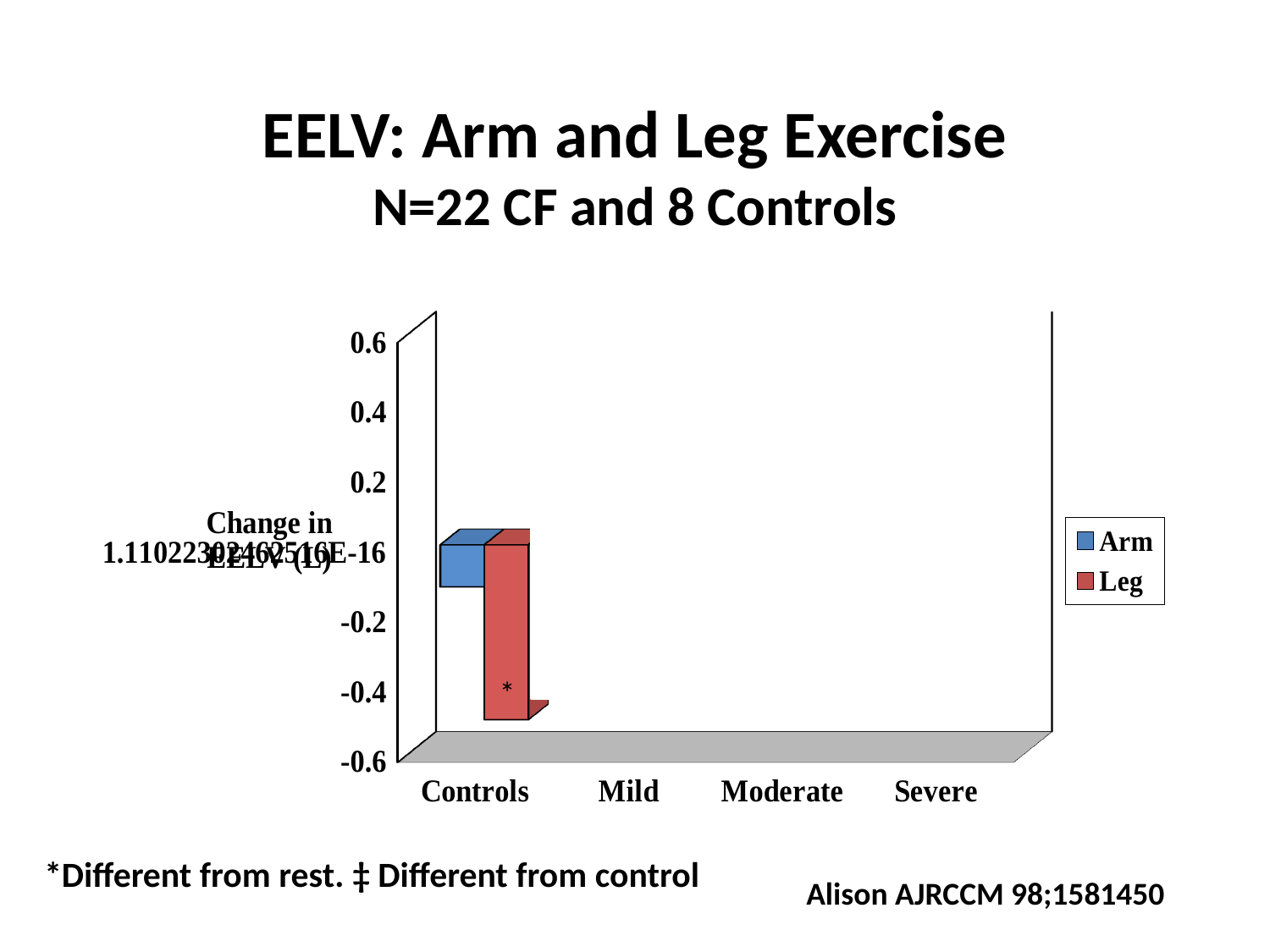
Which two series are listed in the legend? Arm and Leg Is the Leg value for Controls greater or less than -0.6? greater Is the Arm value for Controls greater or less than 0.2? less What colour are the Leg bars? red How many categories are labelled on the x axis? 4 Is the Arm value for Controls greater or less than -0.2? greater For Controls, which series has the larger value, Arm or Leg? Arm Which series has the lowest plotted value on the chart? Leg What kind of chart is shown on the slide? bar chart How many series does the legend list? 2 Which category is the only one with bars plotted? Controls